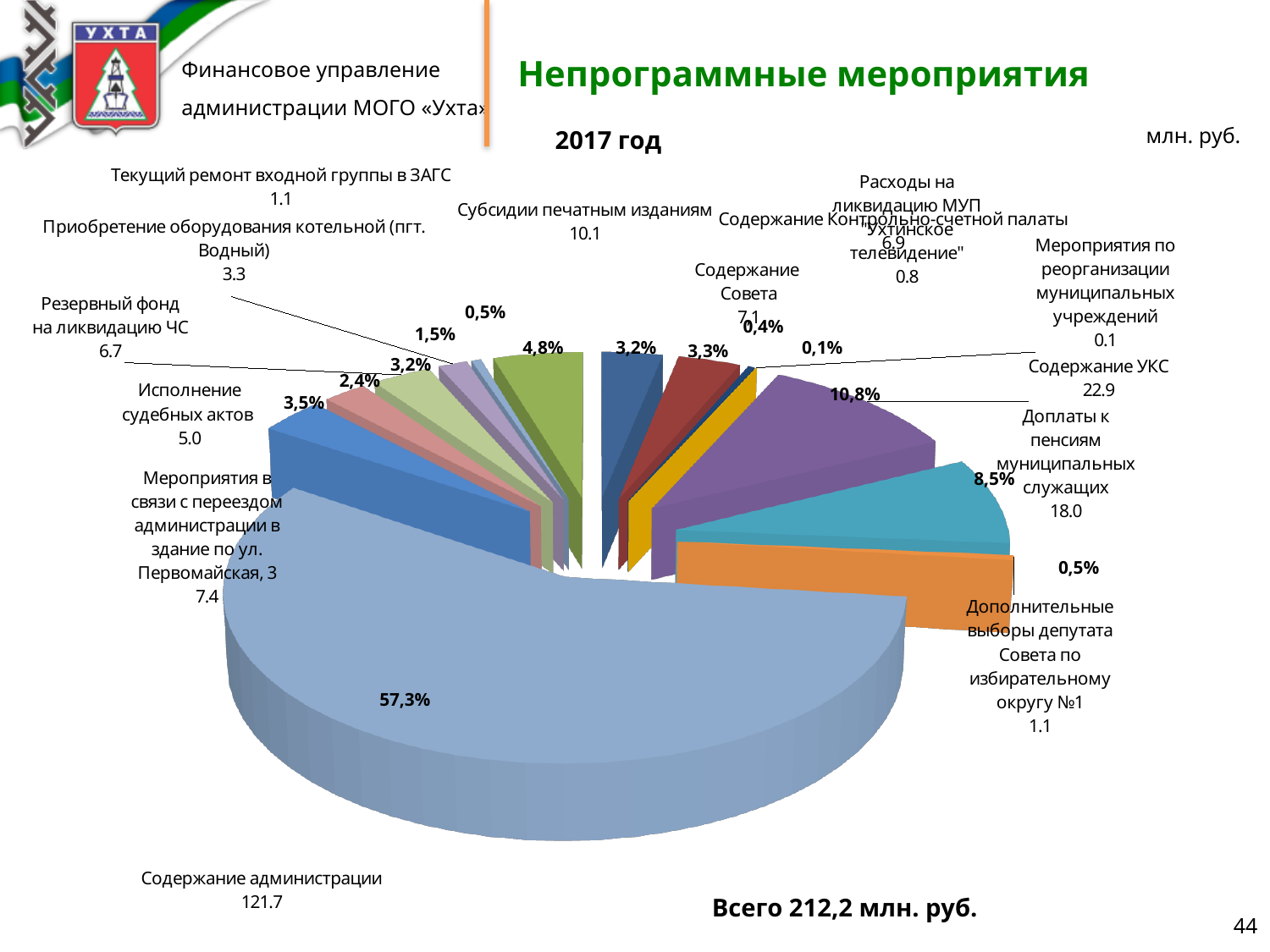
What kind of chart is shown on the slide? pie chart Which category has the highest value? Содержание администрации Which is larger: Субсидии печатным изданиям or Содержание Совета? Субсидии печатным изданиям What is the value for Резервный фонд на ликвидацию ЧС? 6.7 What is the value for Доплаты к пенсиям муниципальных служащих? 18.0 What share of the pie does Содержание администрации take? 57,3% What is the value for Содержание УКС? 22.9 What is the total shown for all non-programme activities? 212,2 млн. руб. What is the difference between Содержание УКС and Доплаты к пенсиям муниципальных служащих? 4.9 What is the value for Содержание администрации? 121.7 Which category has the lowest value? Мероприятия по реорганизации муниципальных учреждений What share of the pie does Содержание УКС take? 10,8%